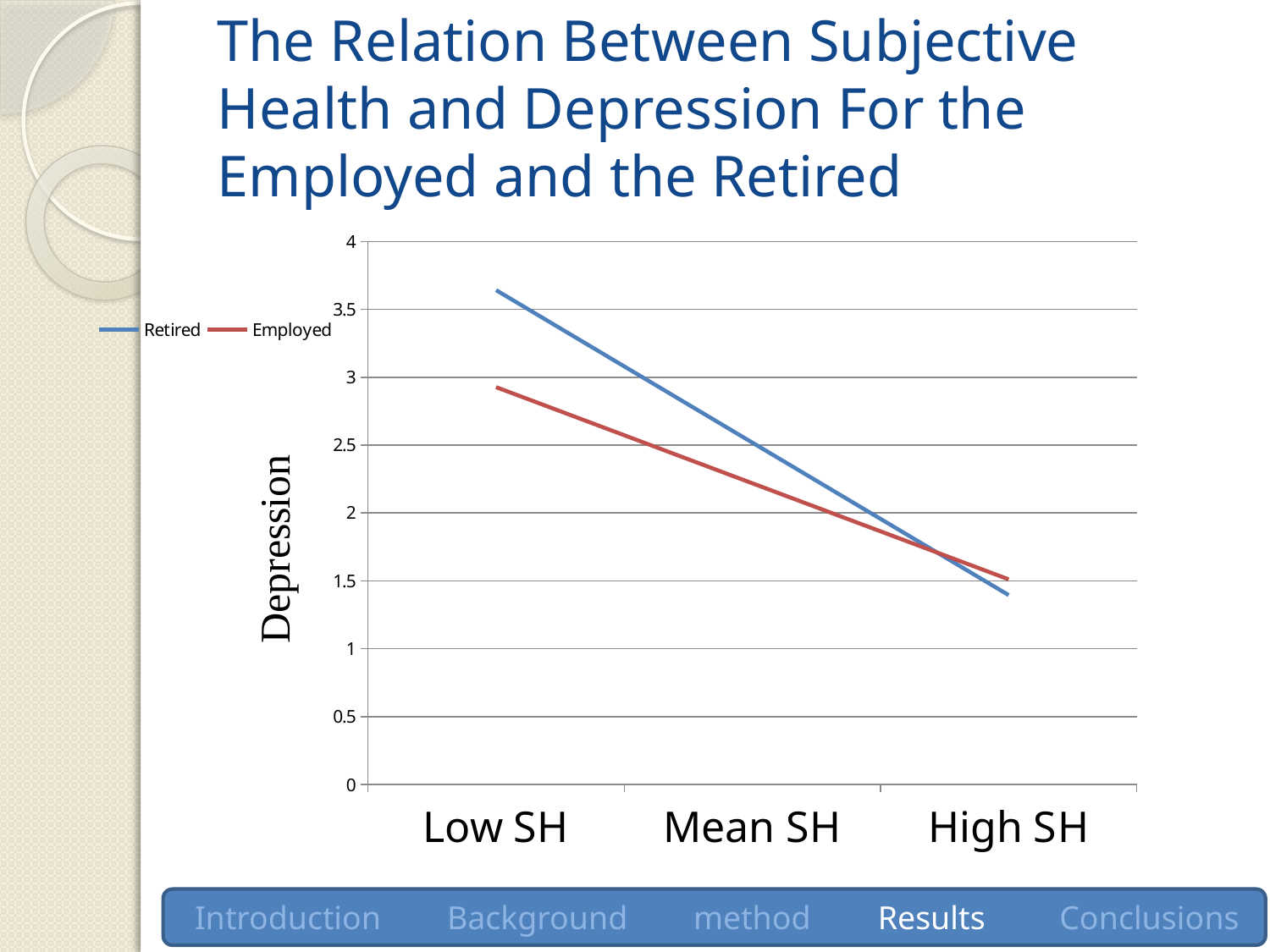
Which colour is used for the Employed series? red Is the Retired value at High SH greater or less than 1.5? less How many categories are shown on the x axis? 3 What is the label of the y axis? Depression What kind of chart is shown on the slide? line chart How many series does the legend list? 2 At Low SH, which series has the higher depression value, Retired or Employed? Retired Is the Employed value at High SH greater or less than 2? less Is the Employed value at Low SH greater or less than 3? less Do the Employed values rise or fall from Low SH to High SH? fall Do the Retired values rise or fall from Low SH to High SH? fall